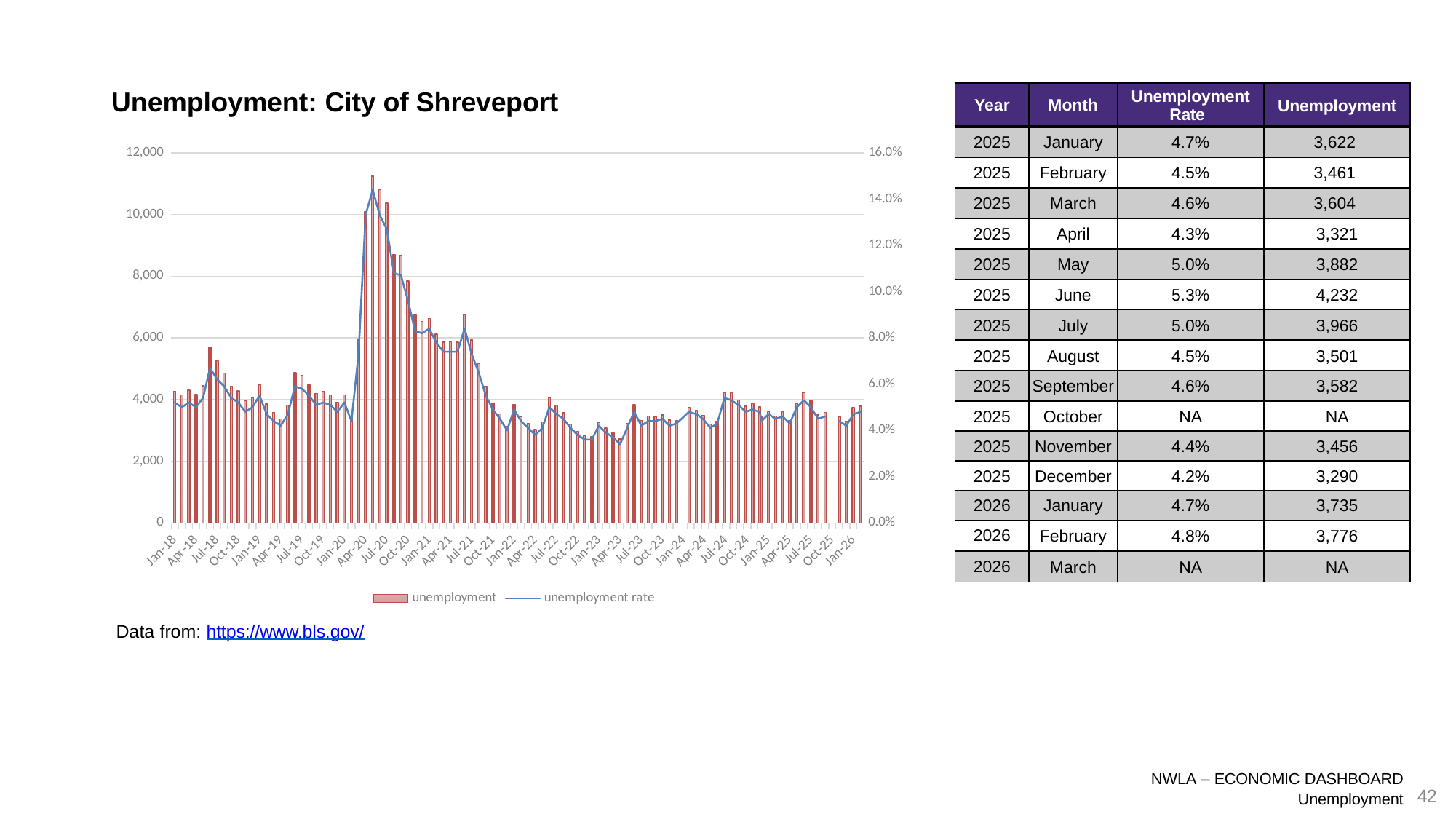
What kind of chart is shown on the slide? A combined bar and line chart In which year does the unemployment bar series reach its highest peak? 2020 Does the unemployment rate line rise or fall between Jul-20 and Jan-22? fall Is the unemployment bar for Jan-23 greater or less than 4,000? less Is the highest unemployment bar on the chart greater or less than 10,000? greater What are the two series named in the chart legend? unemployment and unemployment rate According to the table, what was the unemployment count for February 2026? 3,776 What is the title of the chart? Unemployment: City of Shreveport According to the table, what was the unemployment rate for June 2025? 5.3% How many series does the chart legend list? 2 Is the peak of the unemployment rate line greater or less than 12.0%? greater According to the table, which 2025 month had the highest unemployment count? June